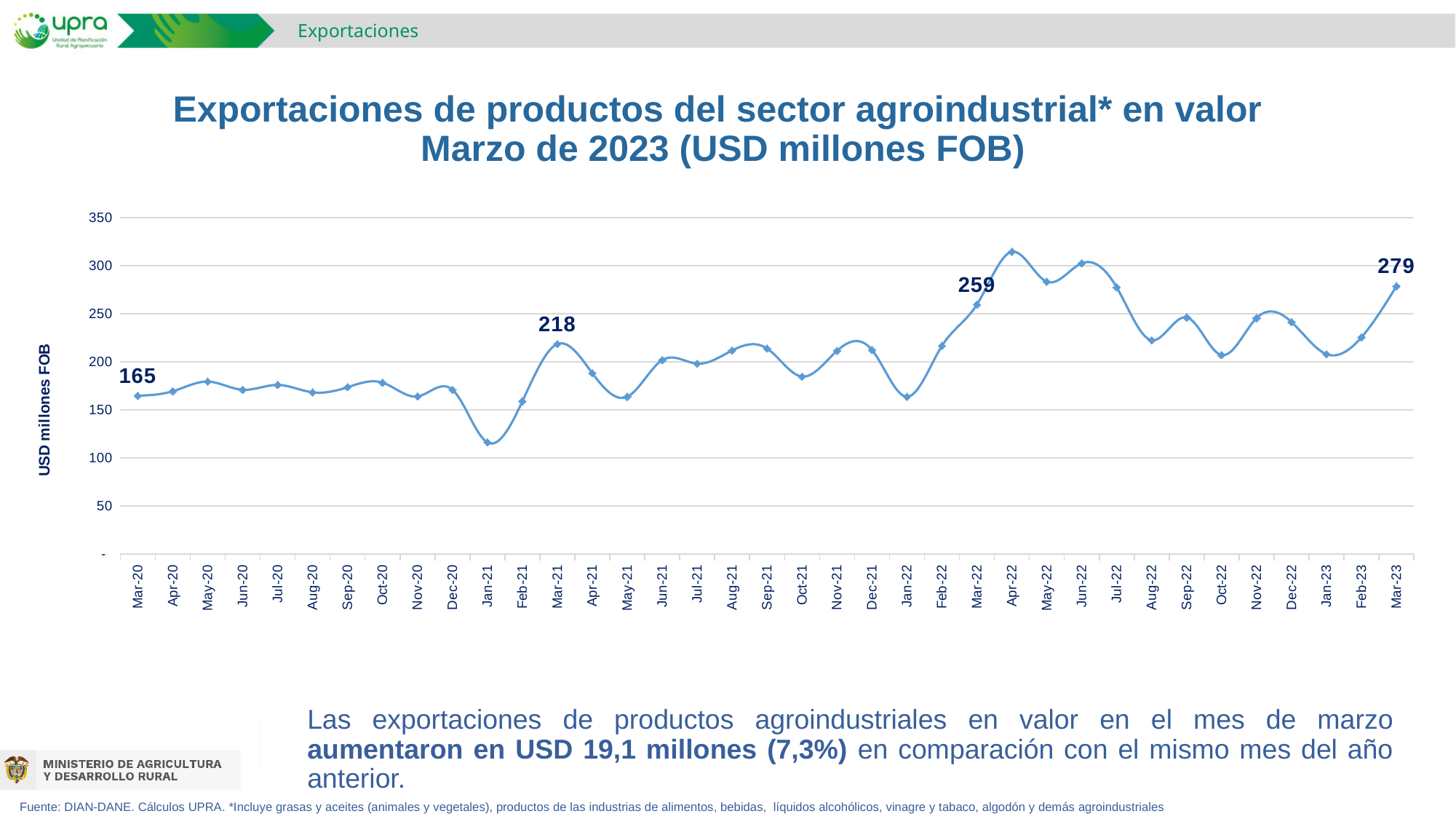
What is the export value for Mar-20? 165 Is the value for Apr-22 greater or less than 300? greater Which month has the highest export value on the chart? Apr-22 What is the export value for Mar-22? 259 What type of chart is shown on the slide? Line chart How many monthly data points are plotted on the chart? 37 What is the export value for Mar-21? 218 What is the export value for Mar-23? 279 What is the title of the vertical axis? USD millones FOB Which is larger, the export value for Mar-22 or for Mar-21? Mar-22 Which month has the lowest export value on the chart? Jan-21 What is the difference between the export values for Mar-23 and Mar-20? 114